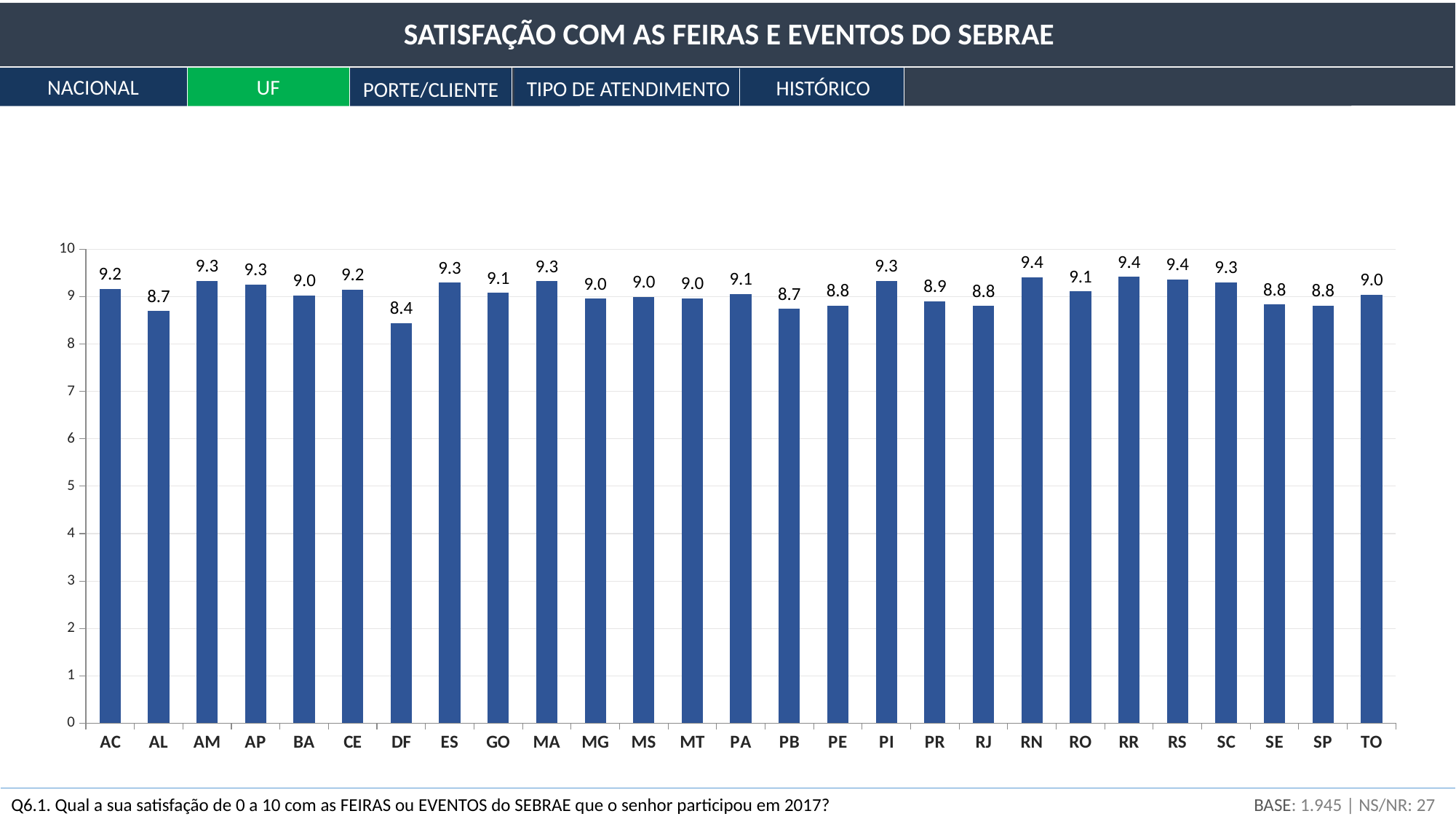
Which state (UF) has the lowest satisfaction value? DF What is the difference between the values for RR and AL? 0.7 How many states (UFs) are shown on the x axis? 27 What is the satisfaction value for SP? 8.8 What kind of chart is shown on the slide? bar chart What is the satisfaction value for PR? 8.9 Which has a higher value, AL or AM? AM What is the title of the slide? SATISFAÇÃO COM AS FEIRAS E EVENTOS DO SEBRAE What is the satisfaction value for RN? 9.4 What is the satisfaction value for DF? 8.4 What is the difference between the values for AM and DF? 0.9 Is the value for DF greater or less than 9? less